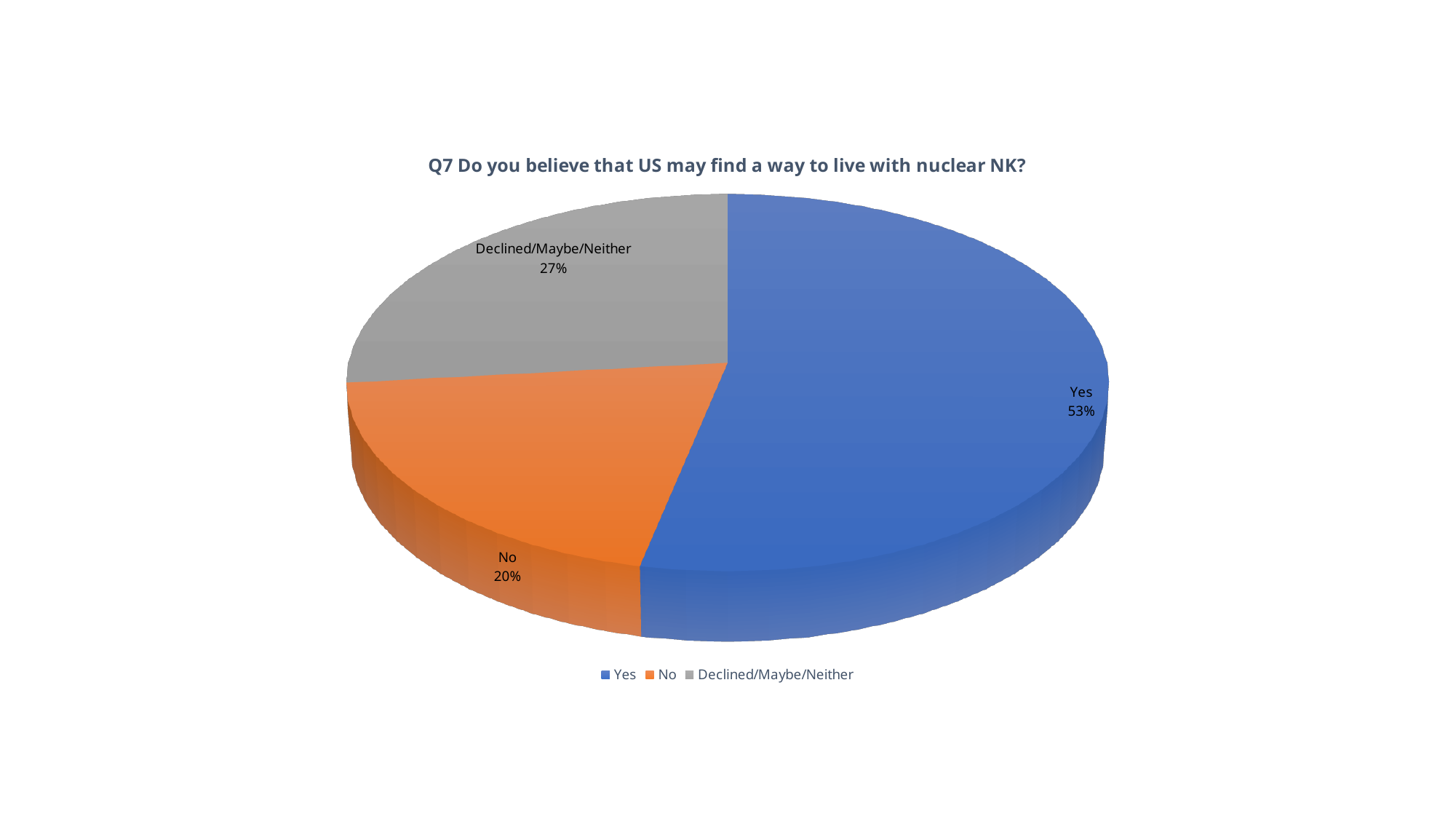
Which response has the smallest share of the pie? No What colour is the Yes slice? Blue What share of respondents answered No? 20% What share of respondents answered Yes? 53% What is the difference in percentage points between the Declined/Maybe/Neither and No shares? 7 Which is larger, the share for No or the share for Declined/Maybe/Neither? Declined/Maybe/Neither What is the title of the chart? Q7 Do you believe that US may find a way to live with nuclear NK? What is the difference in percentage points between the Yes and No shares? 33 What share of respondents fall under Declined/Maybe/Neither? 27% How many slices does the pie chart have? 3 What kind of chart is shown on the slide? Pie chart Which response has the largest share of the pie? Yes